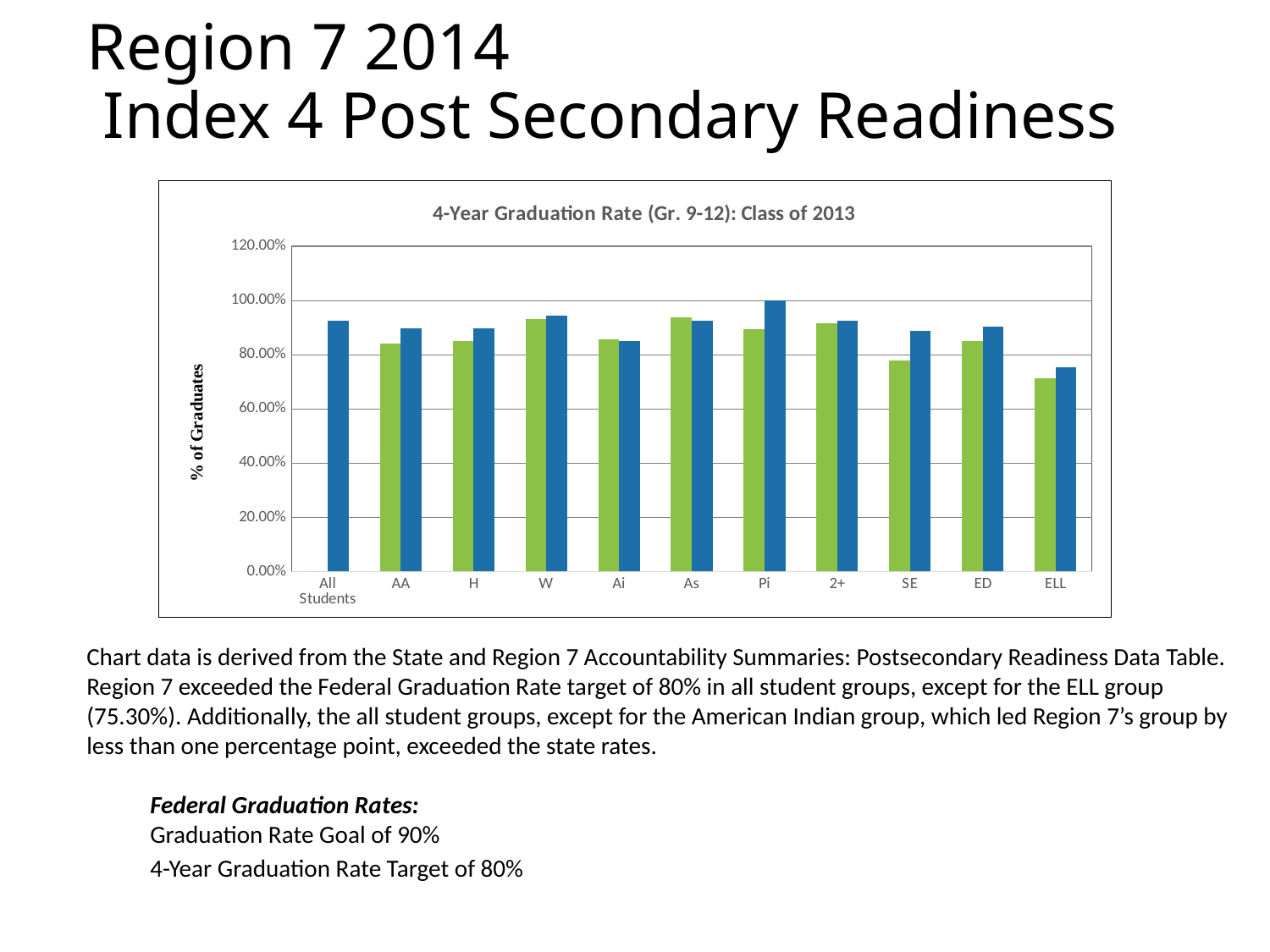
How many student group categories are shown on the x axis of the chart? 11 Which has the taller blue bar, Pi or ELL? Pi Is the blue bar for Pi greater or less than 80.00%? greater Is the green bar for SE greater or less than 80.00%? less Which has the taller green bar, W or ELL? W What is the title of the chart? 4-Year Graduation Rate (Gr. 9-12): Class of 2013 Is the blue bar for All Students greater or less than 80.00%? greater What is the label on the vertical axis of the chart? % of Graduates What type of chart is shown on the slide? bar chart Which category has the shortest bar in the chart? ELL Which category has the tallest bar in the chart? Pi